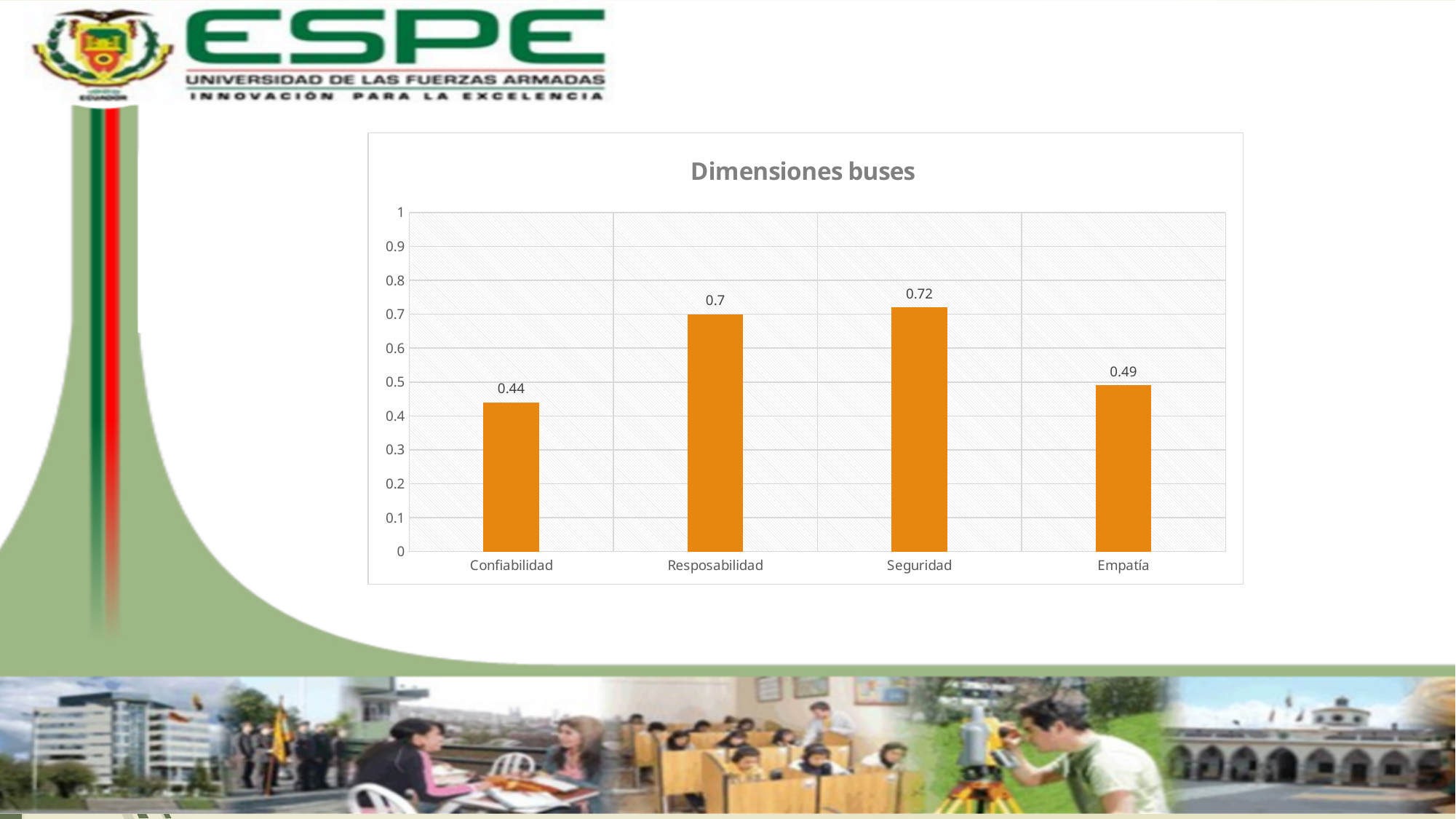
What is the value for Empatía? 0.49 Which category has the highest value? Seguridad Is the value for Resposabilidad greater or less than 0.5? greater What is the difference between the values for Seguridad and Confiabilidad? 0.28 Which category has the lowest value? Confiabilidad What is the value for Seguridad? 0.72 What is the value for Resposabilidad? 0.7 What is the title of the chart? Dimensiones buses How many categories are shown on the x axis? 4 Which is larger, the value for Empatía or the value for Confiabilidad? Empatía What kind of chart is shown on the slide? bar chart What is the value for Confiabilidad? 0.44